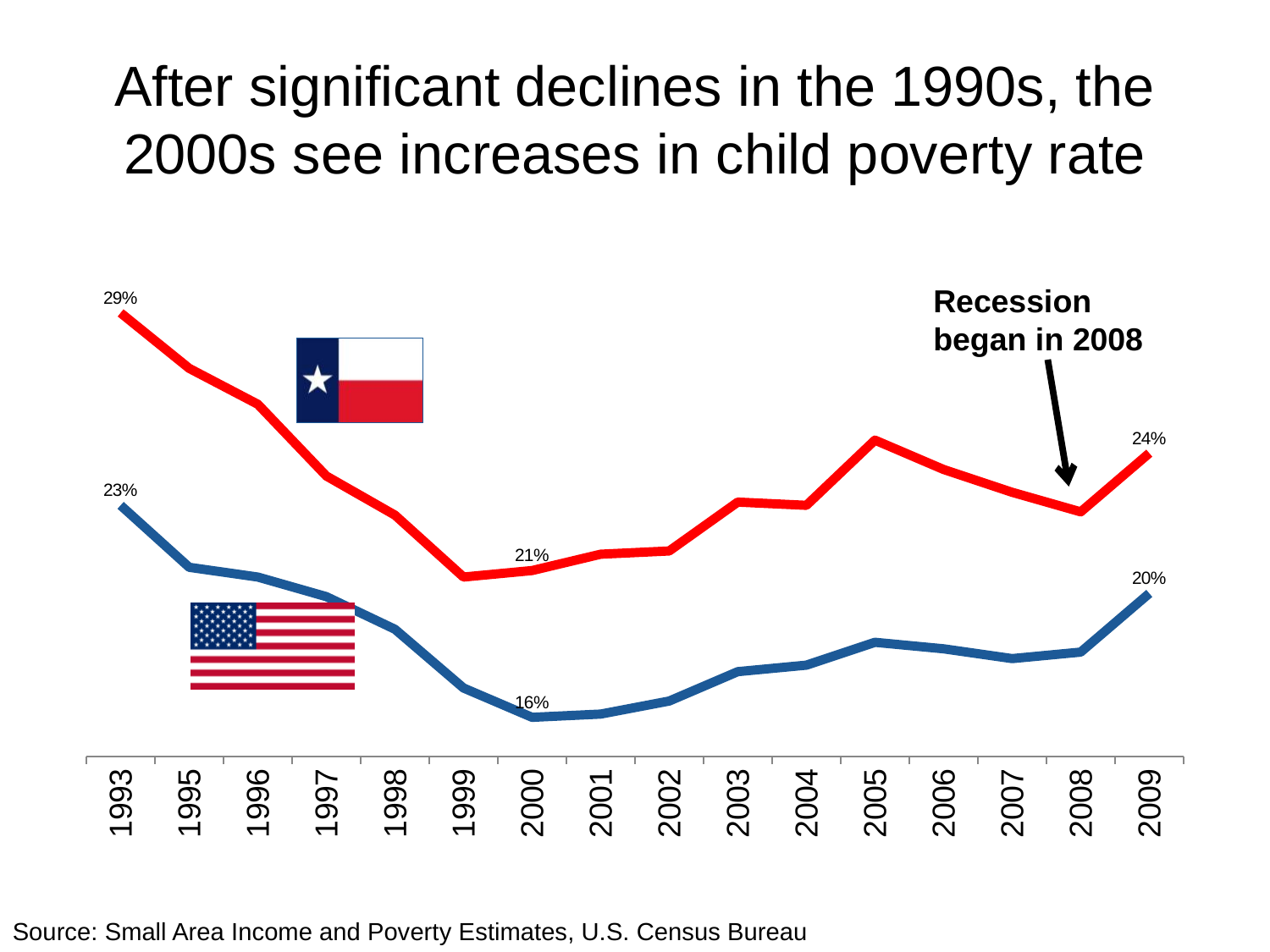
According to the annotation on the chart, in what year did the recession begin? 2008 What is the U.S. child poverty rate shown for 2000? 16% What is the U.S. child poverty rate shown for 2009? 20% What is the Texas child poverty rate shown for 1993? 29% Which line is higher in 2000, Texas or the U.S.? Texas What is the difference between the Texas and U.S. child poverty rates in 2009? 4 percentage points What is the Texas child poverty rate shown for 2009? 24% How many years are labeled on the x axis? 16 What is the Texas child poverty rate shown for 2000? 21% What is the U.S. child poverty rate shown for 1993? 23% What kind of chart is shown on the slide? Line chart By how many percentage points did the Texas child poverty rate fall from 1993 to 2000? 8 percentage points